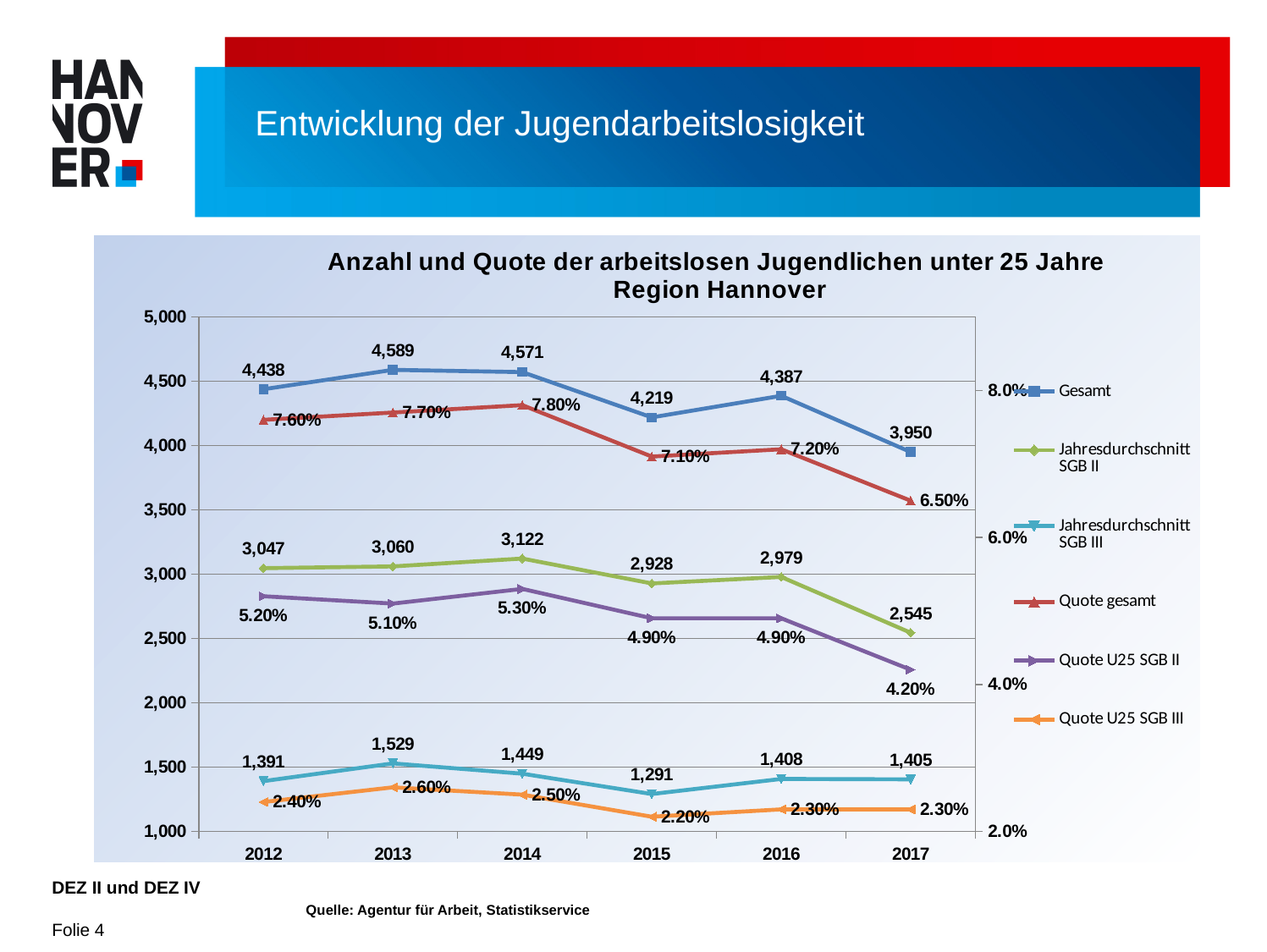
What is the title of the chart? Anzahl und Quote der arbeitslosen Jugendlichen unter 25 Jahre Region Hannover What is the value of Jahresdurchschnitt SGB II in 2017? 2,545 What kind of chart is shown on the slide? line chart Does the Quote gesamt series rise or fall from 2014 to 2017? fall What is the value of the Gesamt series in 2013? 4,589 Which is larger, the Quote U25 SGB II value in 2012 or in 2017? 2012 How many years are shown on the x axis? 6 What is the Quote gesamt value in 2014? 7.80% What is the difference between the Gesamt values in 2012 and 2017? 488 How many series does the legend list? 6 In which year is the Gesamt series lowest? 2017 In which year is Jahresdurchschnitt SGB III highest? 2013